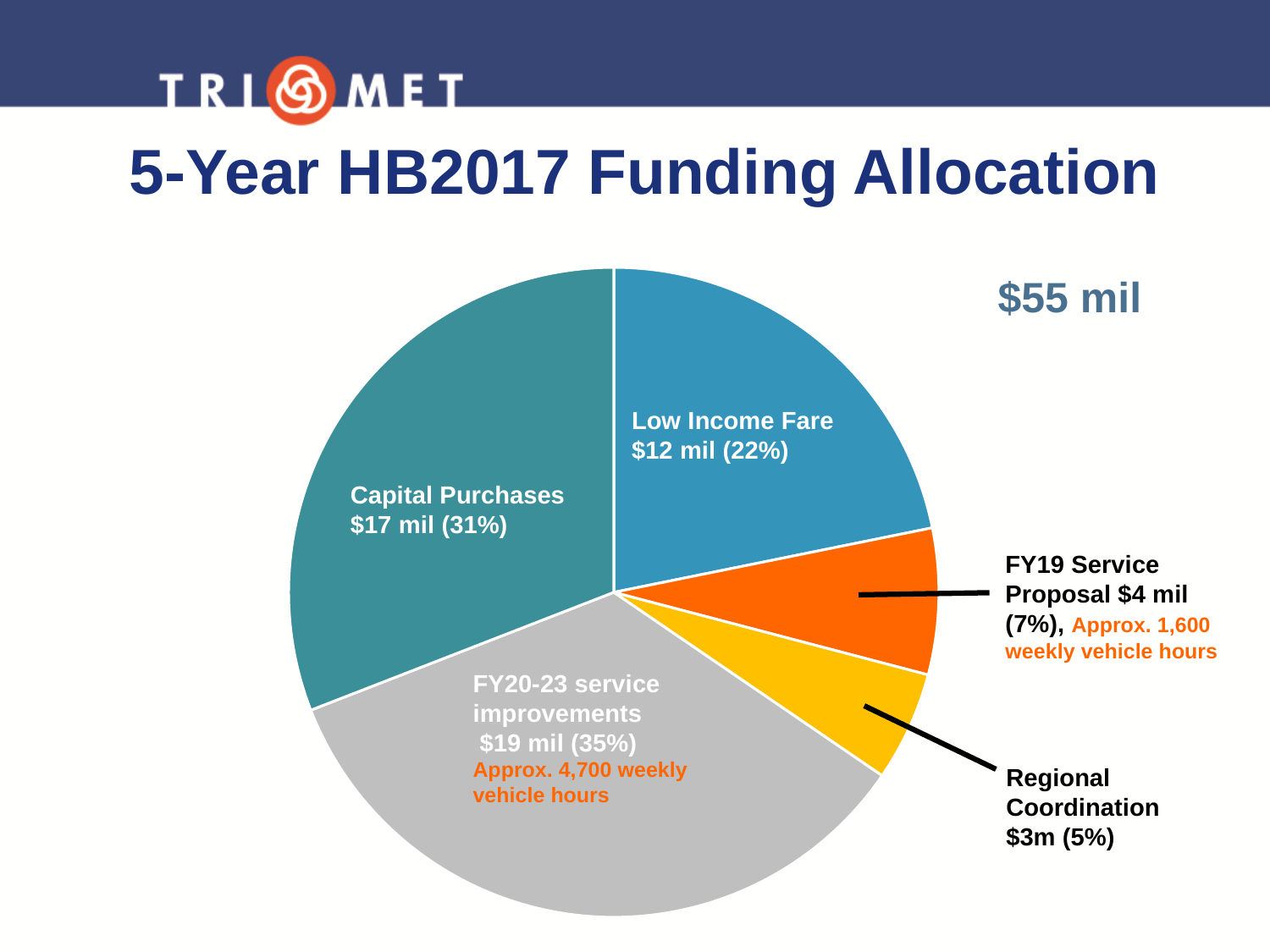
What is the difference in funding between Capital Purchases and Low Income Fare? $5 mil Which category receives the largest funding allocation? FY20-23 service improvements What share of the pie does FY20-23 service improvements represent? 35% What kind of chart is shown on the slide? pie chart What is the funding amount for Capital Purchases? $17 mil What is the total funding amount shown on the slide? $55 mil What is the title of the slide? 5-Year HB2017 Funding Allocation What is the funding amount for Low Income Fare? $12 mil Which receives more funding, FY19 Service Proposal or Regional Coordination? FY19 Service Proposal Which category receives the smallest funding allocation? Regional Coordination What share of the pie does Regional Coordination represent? 5% How many slices does the pie chart have? 5